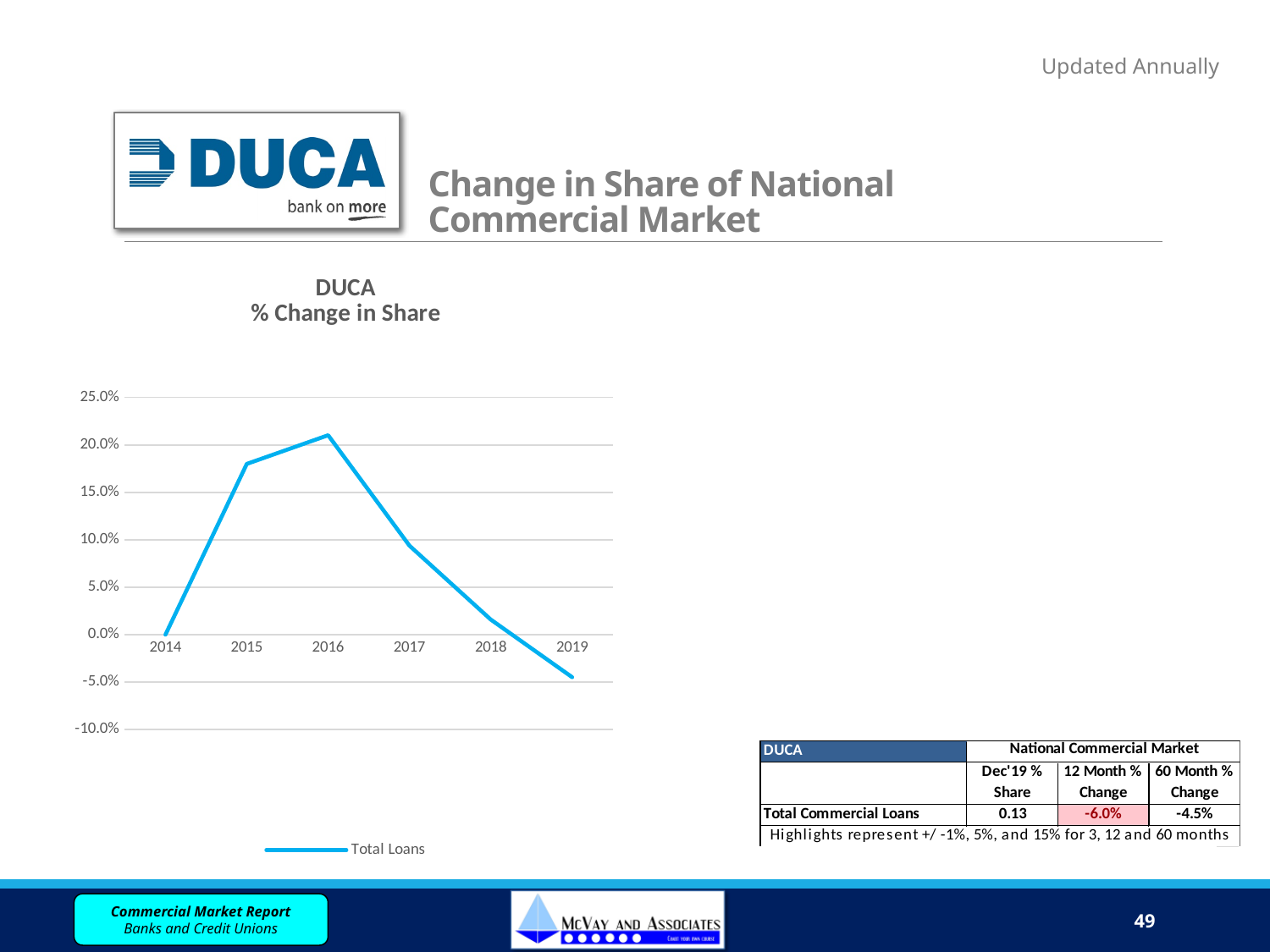
Which year has a higher % change in share, 2018 or 2019? 2018 Is the value for 2016 greater or less than 15.0%? greater Is the value for 2019 greater or less than 0.0%? less Do the values rise or fall from 2016 to 2019? fall How many years are plotted along the x axis of the chart? 6 What kind of chart is shown on the slide? line chart How many series does the chart legend list? 1 Which year has a higher % change in share, 2015 or 2017? 2015 Which year has the highest % change in share? 2016 Is the value for 2017 greater or less than 15.0%? less Which year has the lowest % change in share? 2019 What series name is shown in the chart legend? Total Loans